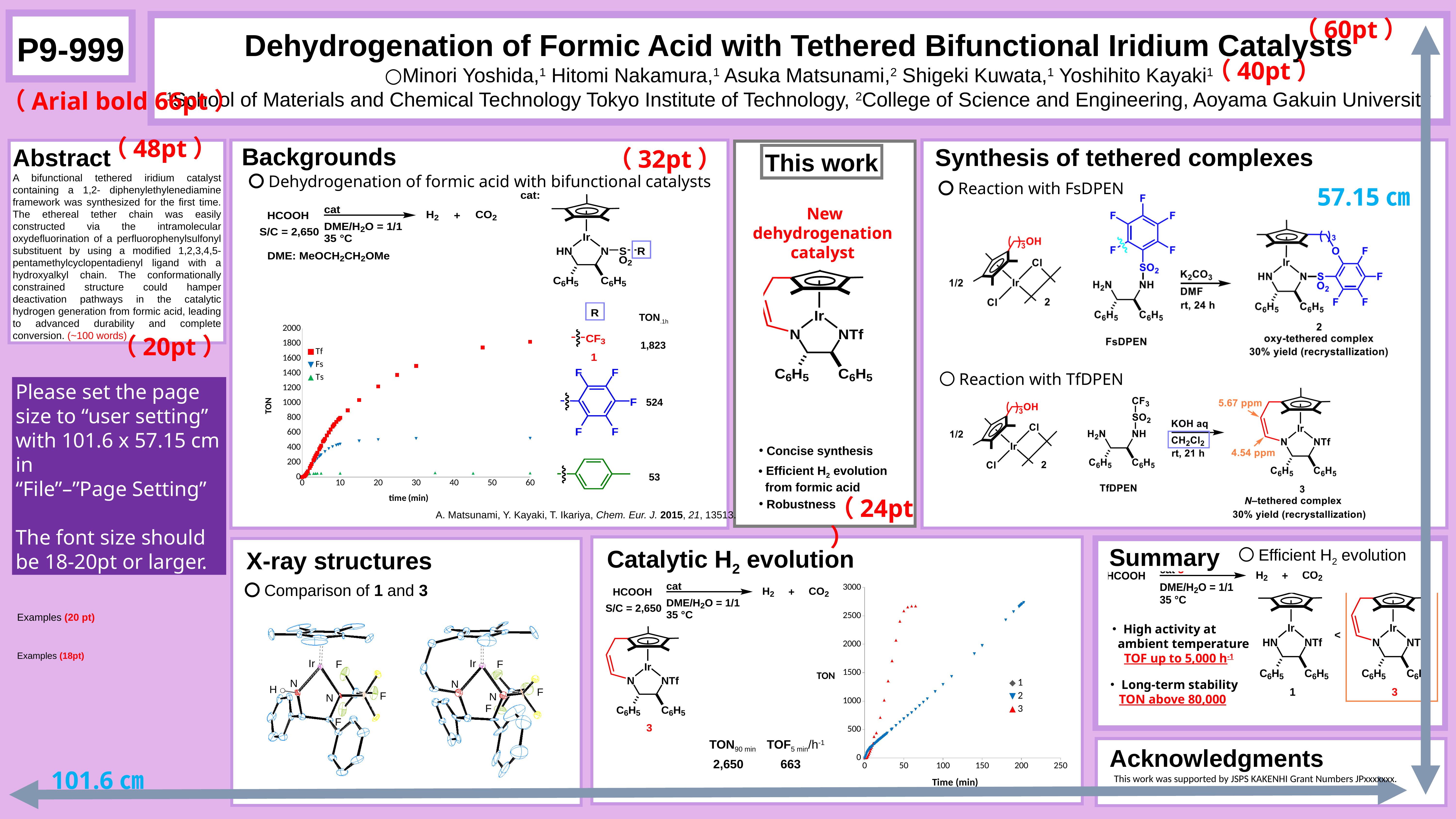
In the Backgrounds chart (TON vs time), which series has the lowest TON? Ts In the Backgrounds chart (TON vs time), does the TON for Tf rise or fall as time increases? rise In the Backgrounds chart (TON vs time), which series reaches the highest TON? Tf In the Backgrounds chart (TON vs time), is the TON for Tf at 60 min greater or less than 1600? greater In the Catalytic H2 evolution chart, is the TON for series 3 at 50 min greater or less than 2000? greater In the Catalytic H2 evolution chart, which series reaches a TON above 2500 in the shortest time? 3 In the Catalytic H2 evolution chart, how many series does the legend list? 3 In the Backgrounds chart (TON vs time), how many series does the legend list? 3 In the Backgrounds chart (TON vs time), what is the label of the x axis? time (min) In the Backgrounds chart (TON vs time), is the TON for Fs at 60 min greater or less than 1000? less In the Catalytic H2 evolution chart, what is the label of the x axis? Time (min)